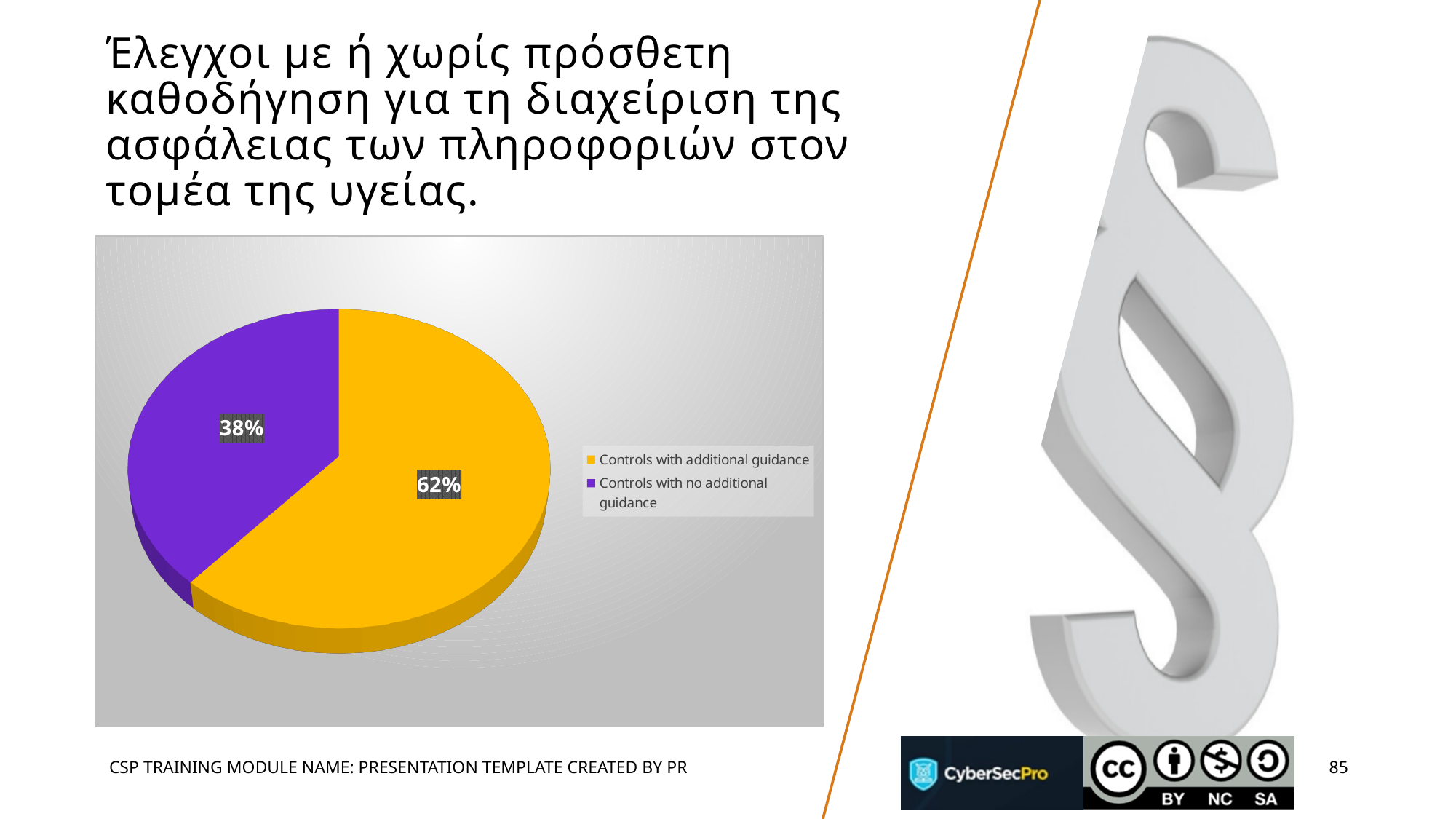
How many slices does the pie chart have? 2 What colour is the slice for 'Controls with no additional guidance'? Purple Which category has the largest slice of the pie? Controls with additional guidance Which category has the smallest slice of the pie? Controls with no additional guidance What share of the pie is labelled 'Controls with no additional guidance'? 38% What kind of chart is shown on the slide? Pie chart What share of the pie is labelled 'Controls with additional guidance'? 62% Which is larger: the slice for 'Controls with additional guidance' or the slice for 'Controls with no additional guidance'? Controls with additional guidance How many entries does the legend list? 2 What colour is the slice for 'Controls with additional guidance'? Yellow What is the difference in percentage points between the 'Controls with additional guidance' slice and the 'Controls with no additional guidance' slice? 24